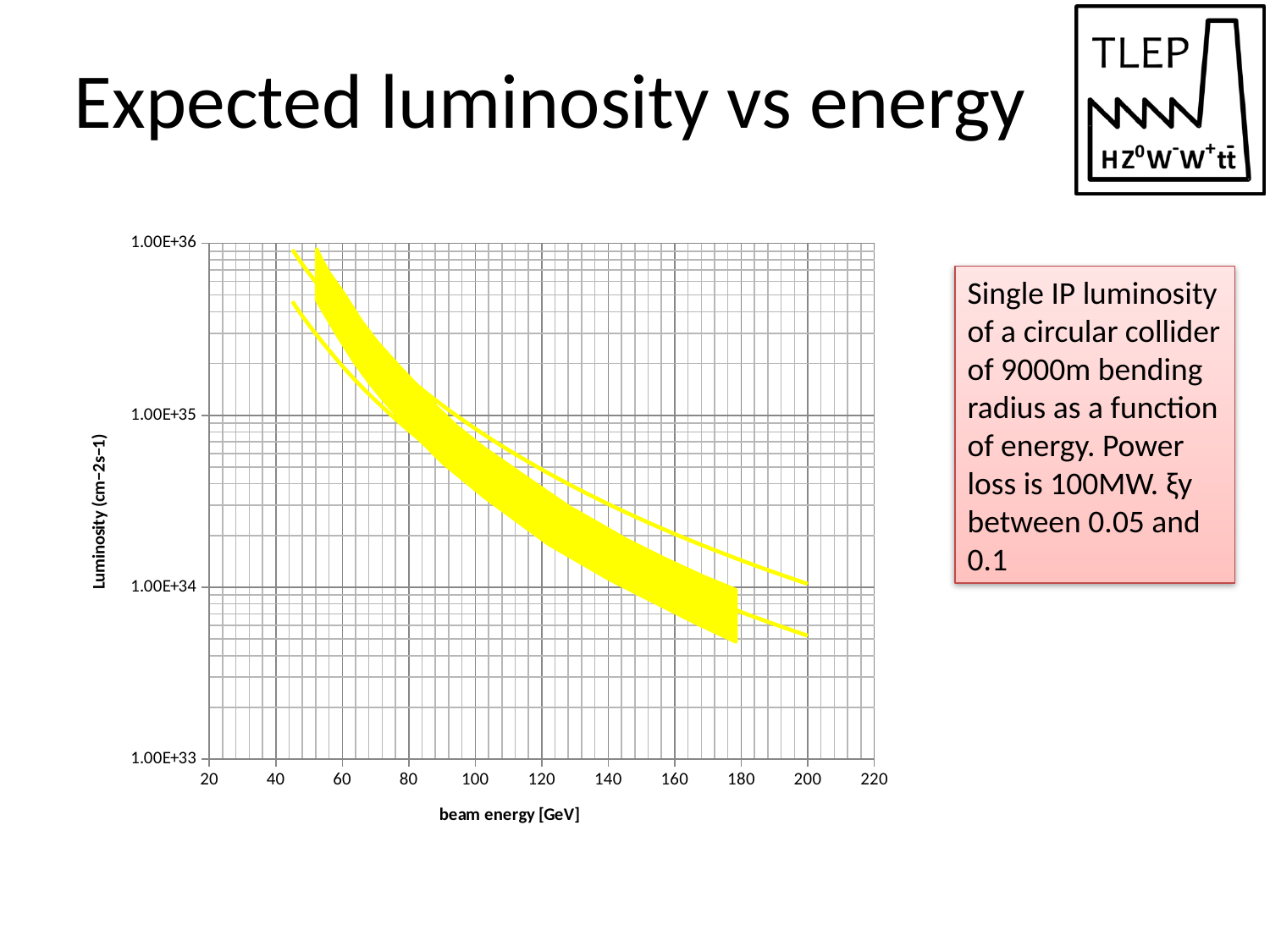
What is the title of the slide containing the chart? Expected luminosity vs energy Is the luminosity at a beam energy of 140 GeV greater or less than 1.00E+35? less What is the highest value shown on the y axis of the chart? 1.00E+36 Which has the higher luminosity, a beam energy of 60 GeV or 160 GeV? 60 GeV Is the luminosity at a beam energy of 60 GeV greater or less than 1.00E+35? greater Is the luminosity at a beam energy of 140 GeV greater or less than 1.00E+34? greater Does the luminosity rise or fall as beam energy increases along the x axis? fall What is the x-axis label of the chart? beam energy [GeV] What is the lowest value shown on the y axis of the chart? 1.00E+33